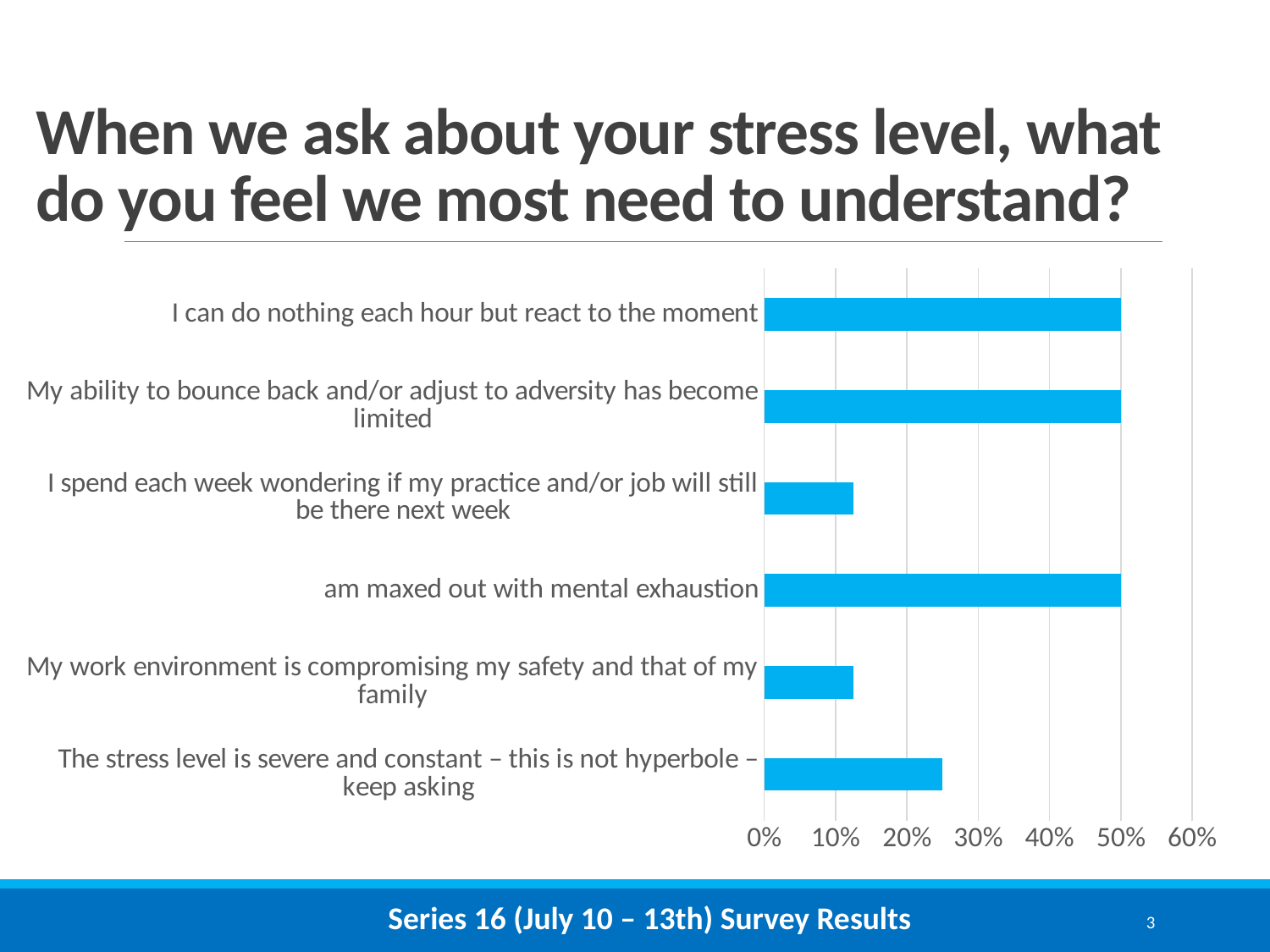
Which is larger: the value for "am maxed out with mental exhaustion" or the value for "The stress level is severe and constant – this is not hyperbole – keep asking"? am maxed out with mental exhaustion What is the value for "My ability to bounce back and/or adjust to adversity has become limited"? 50% How many categories does the chart show? 6 What is the highest value shown on the x axis? 60% What is the value for "I can do nothing each hour but react to the moment"? 50% What kind of chart is shown on the slide? bar chart What colour are the bars in the chart? blue Is the value for "The stress level is severe and constant – this is not hyperbole – keep asking" greater or less than 30%? less Which is larger: the value for "My work environment is compromising my safety and that of my family" or the value for "I can do nothing each hour but react to the moment"? I can do nothing each hour but react to the moment Is the value for "I spend each week wondering if my practice and/or job will still be there next week" greater or less than 20%? less Is the value for "My work environment is compromising my safety and that of my family" greater or less than 10%? greater What is the value for "am maxed out with mental exhaustion"? 50%